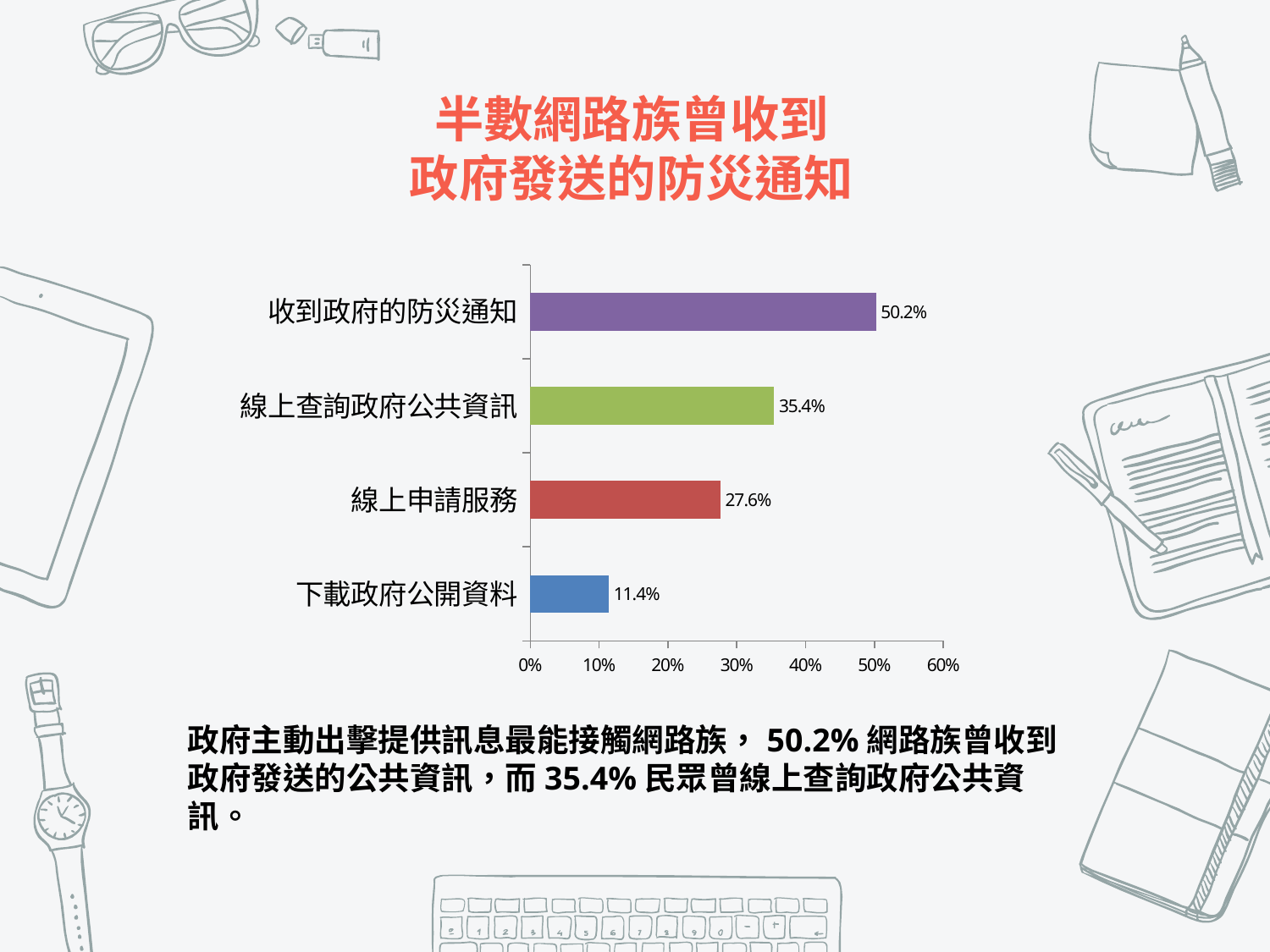
What is the difference between the values for 收到政府的防災通知 and 線上查詢政府公共資訊? 14.8% Which category has the lowest value? 下載政府公開資料 Which category has the highest value? 收到政府的防災通知 How many categories are shown in the chart? 4 Is the value for 線上申請服務 greater or less than 30%? less What is the value for 線上申請服務? 27.6% What is the difference between the values for 線上申請服務 and 下載政府公開資料? 16.2% What is the value for 收到政府的防災通知? 50.2% What is the value for 線上查詢政府公共資訊? 35.4% Which is larger, the value for 線上查詢政府公共資訊 or the value for 線上申請服務? 線上查詢政府公共資訊 What is the value for 下載政府公開資料? 11.4% What kind of chart is shown on the slide? bar chart